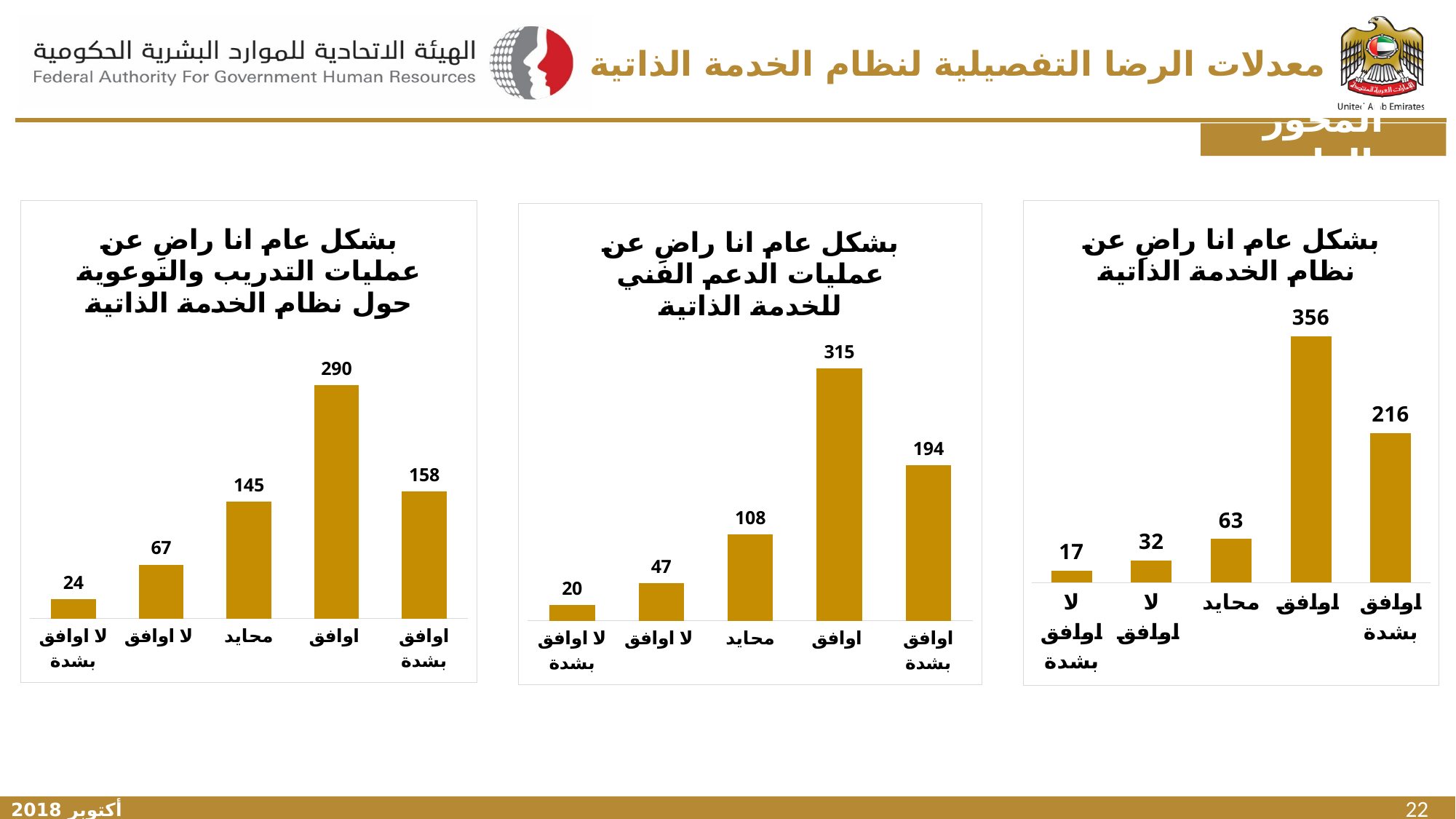
In the middle chart (about عمليات الدعم الفني), what is the value for محايد? 108 In the middle chart, which category has the lowest value? لا اوافق بشدة What colour are the bars in the left-hand chart? gold In the left-hand chart (about عمليات التدريب والتوعوية), what is the value for لا اوافق بشدة? 24 How many charts are shown on the slide? 3 In the left-hand chart, which category has the highest value? اوافق In the right-hand chart, what is the difference between the values for اوافق and اوافق بشدة? 140 In the left-hand chart, what is the difference between the values for محايد and لا اوافق? 78 In the middle chart, which is larger: the value for اوافق بشدة or the value for محايد? اوافق بشدة How many categories are shown on the x axis of the right-hand chart? 5 What type of chart is the middle chart? bar chart In the right-hand chart (بشكل عام انا راض عن نظام الخدمة الذاتية), what is the value for اوافق? 356